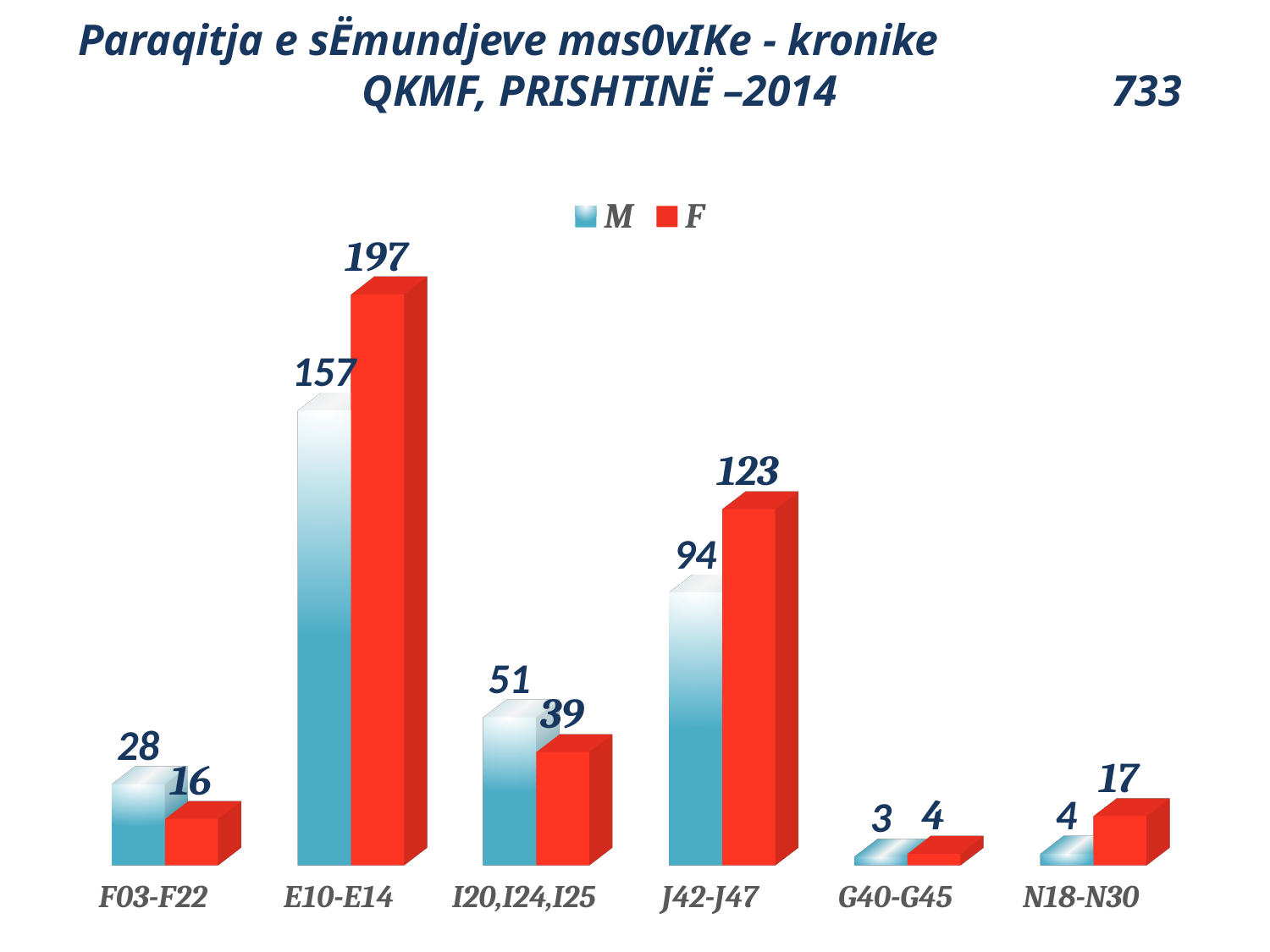
How many series does the legend list? 2 What is the difference between the M and F values in the I20,I24,I25 category? 12 What is the value for M in the J42-J47 category? 94 What is the value for F in the E10-E14 category? 197 What kind of chart is shown on the slide? bar chart Which category has the highest value for M? E10-E14 Which category has the lowest value for M? G40-G45 What is the value for F in the N18-N30 category? 17 How many categories are shown on the x axis? 6 Which is larger in the F03-F22 category, M or F? M What is the difference between the F and M values in the E10-E14 category? 40 Which colour represents the F series in the legend? red